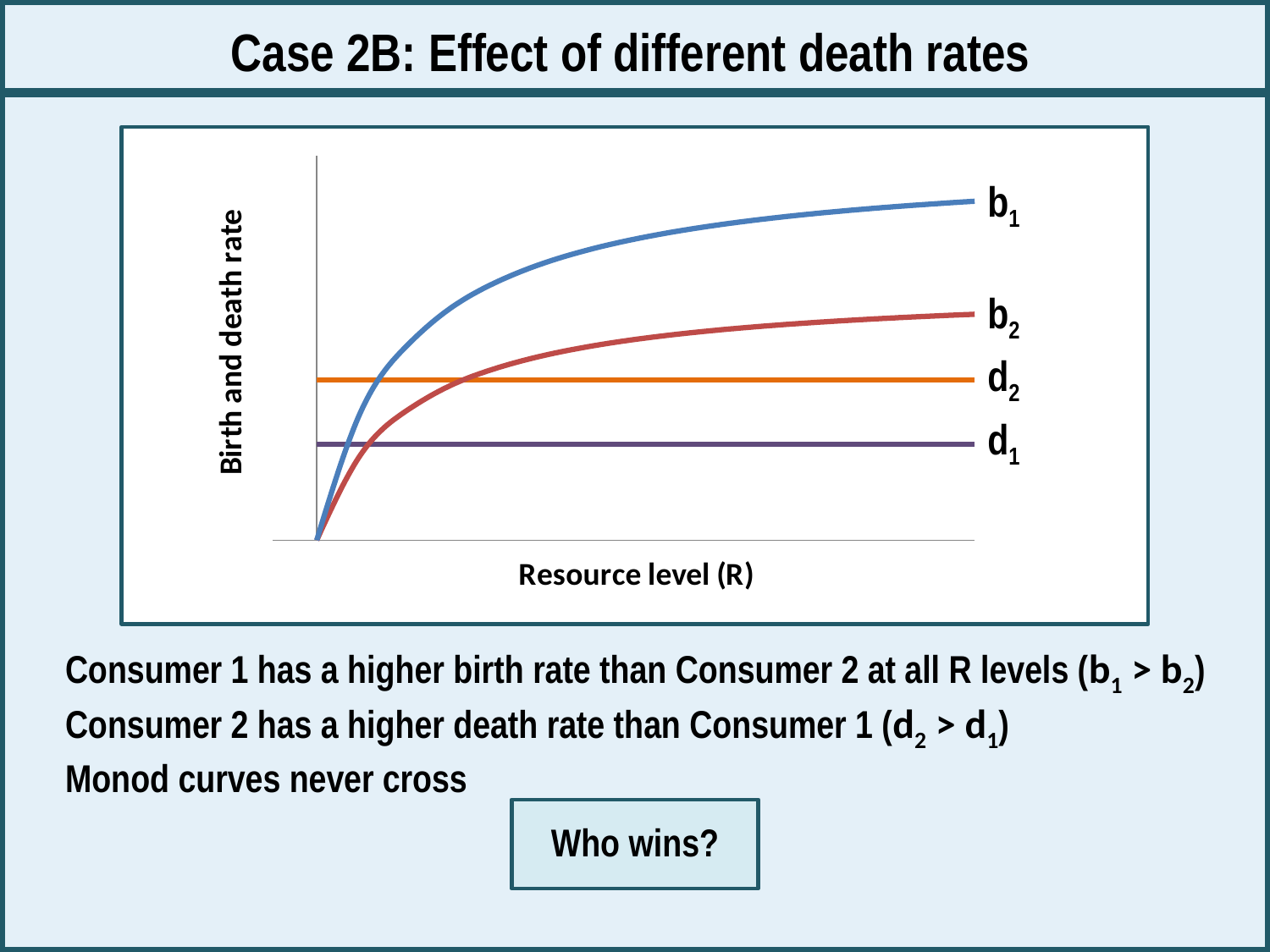
Which horizontal line is higher, d1 or d2? d2 How many curves are labelled on the chart? 4 Which is higher at the right-hand end of the chart, b2 or d2? b2 Which curve is lowest at the right-hand end of the chart? d1 Does the b1 curve rise or fall as resource level (R) increases? rise Which curve is highest at the right-hand end of the chart? b1 Which is higher at high resource levels, b1 or b2? b1 What is the label of the x axis? Resource level (R) Does the d1 line rise, fall, or stay flat as resource level (R) increases? stay flat What is the label of the y axis? Birth and death rate Does the b2 curve rise or fall as resource level (R) increases? rise What kind of chart is shown on the slide? line chart